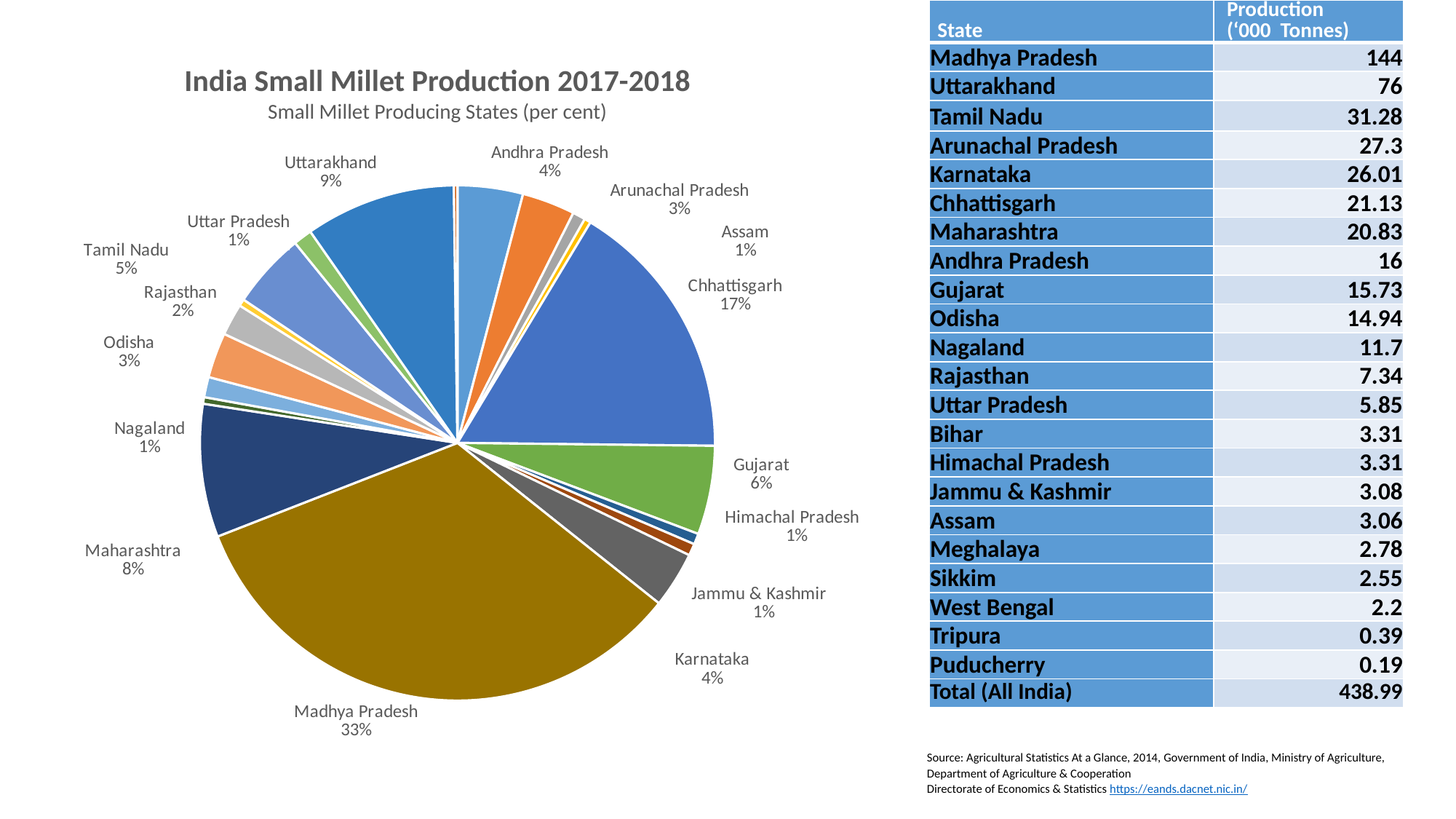
What is the difference in percentage points between Uttarakhand and Andhra Pradesh in the pie chart? 5 What percentage is shown for Chhattisgarh in the pie chart? 17% What percentage is shown for Uttarakhand in the pie chart? 9% What share of the pie does Madhya Pradesh hold? 33% Which is larger in the pie chart, Maharashtra or Tamil Nadu? Maharashtra What percentage is shown for Odisha in the pie chart? 3% What percentage is shown for Gujarat in the pie chart? 6% What kind of chart is shown on the slide? Pie chart What is the title of the chart? India Small Millet Production 2017-2018 What is the difference in percentage points between Madhya Pradesh and Chhattisgarh in the pie chart? 16 What is the subtitle shown below the chart title? Small Millet Producing States (per cent) Which state has the largest slice of the pie chart? Madhya Pradesh